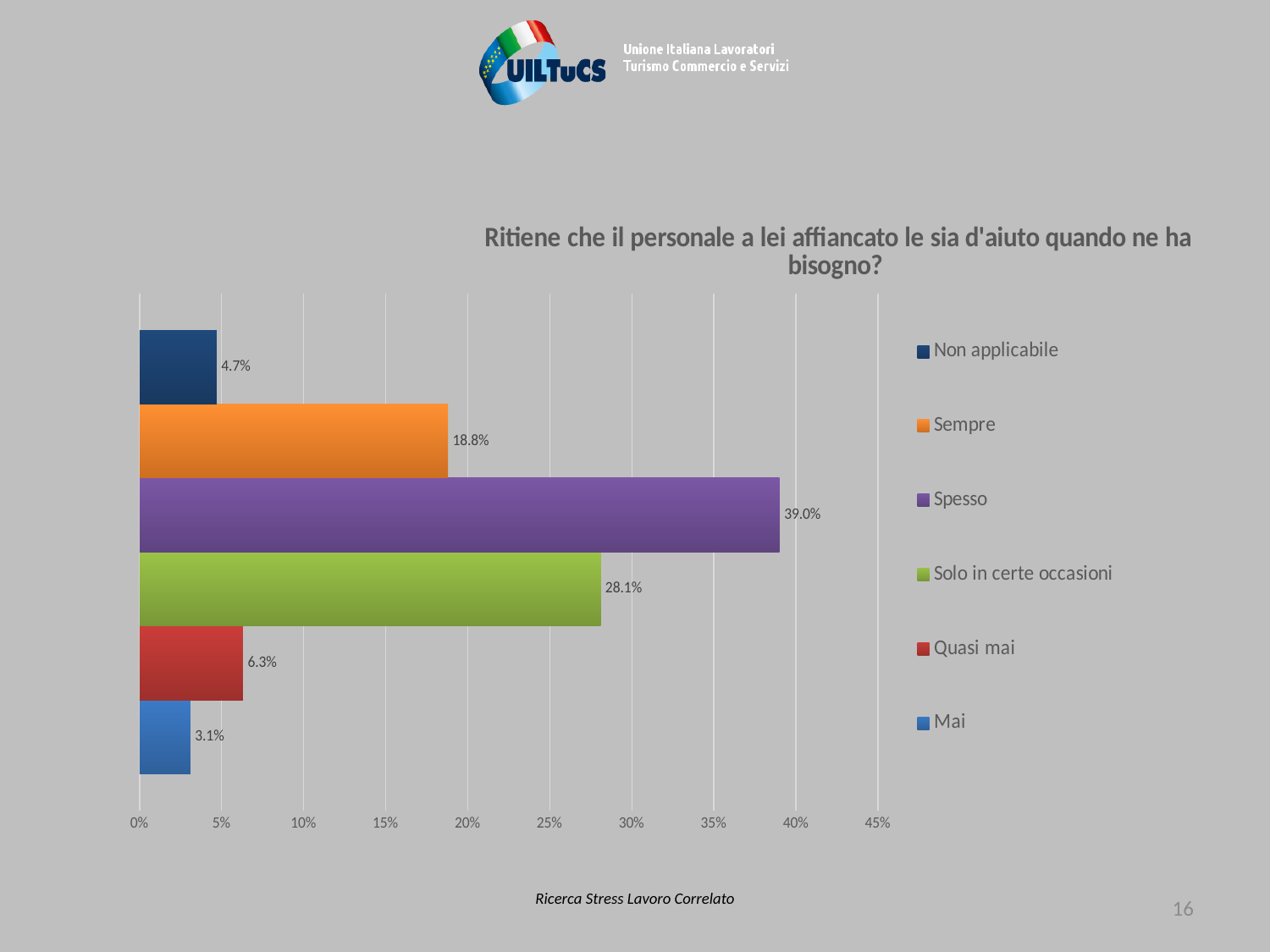
How many categories are shown in the chart? 6 What kind of chart is shown on the slide? bar chart What is the value for Sempre? 18.8% What is the value for Non applicabile? 4.7% What is the value for Spesso? 39.0% Which is larger, the value for Quasi mai or the value for Non applicabile? Quasi mai Is the value for Solo in certe occasioni greater or less than 25%? greater What is the difference between the values for Spesso and Solo in certe occasioni? 10.9% Which category has the highest value? Spesso What is the title of the chart? Ritiene che il personale a lei affiancato le sia d'aiuto quando ne ha bisogno? Which category has the lowest value? Mai What is the value for Mai? 3.1%